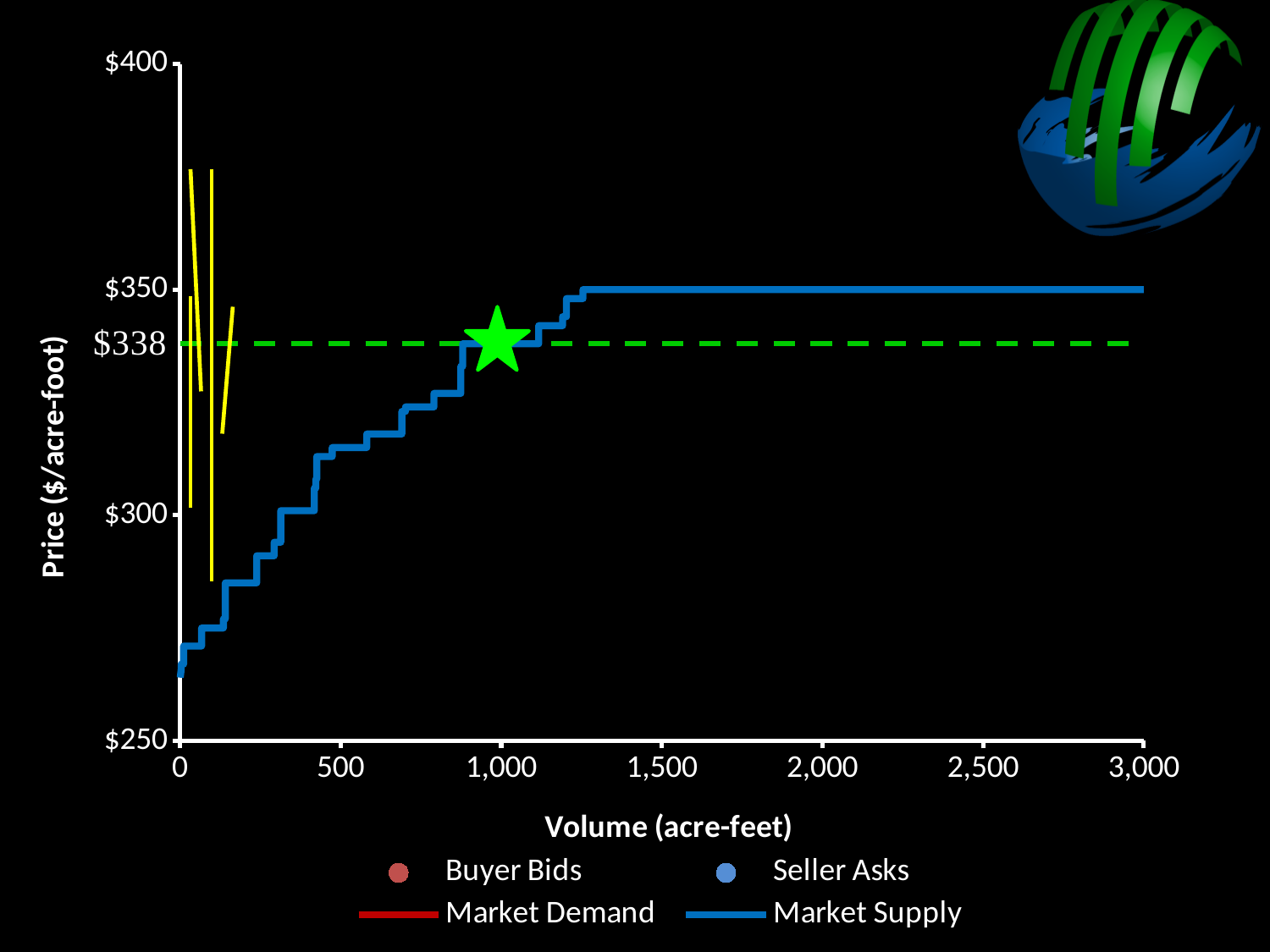
Is the Market Supply price at a volume of 500 acre-feet greater or less than $300? greater How many tick labels are shown on the x axis? 7 What price does the horizontal dashed green line mark? $338 What is the title of the y axis? Price ($/acre-foot) Is the Market Supply price at a volume of 2,500 acre-feet greater or less than $338? greater What is the Market Supply price at a volume of 3,000 acre-feet? $350 Does the Market Supply curve rise or fall as volume increases? rise What is the title of the x axis? Volume (acre-feet) What is the highest price the Market Supply curve reaches? $350 Is the Market Supply price at a volume of 0 acre-feet greater or less than $300? less What kind of chart is shown on the slide? line chart How many series does the legend list? 4